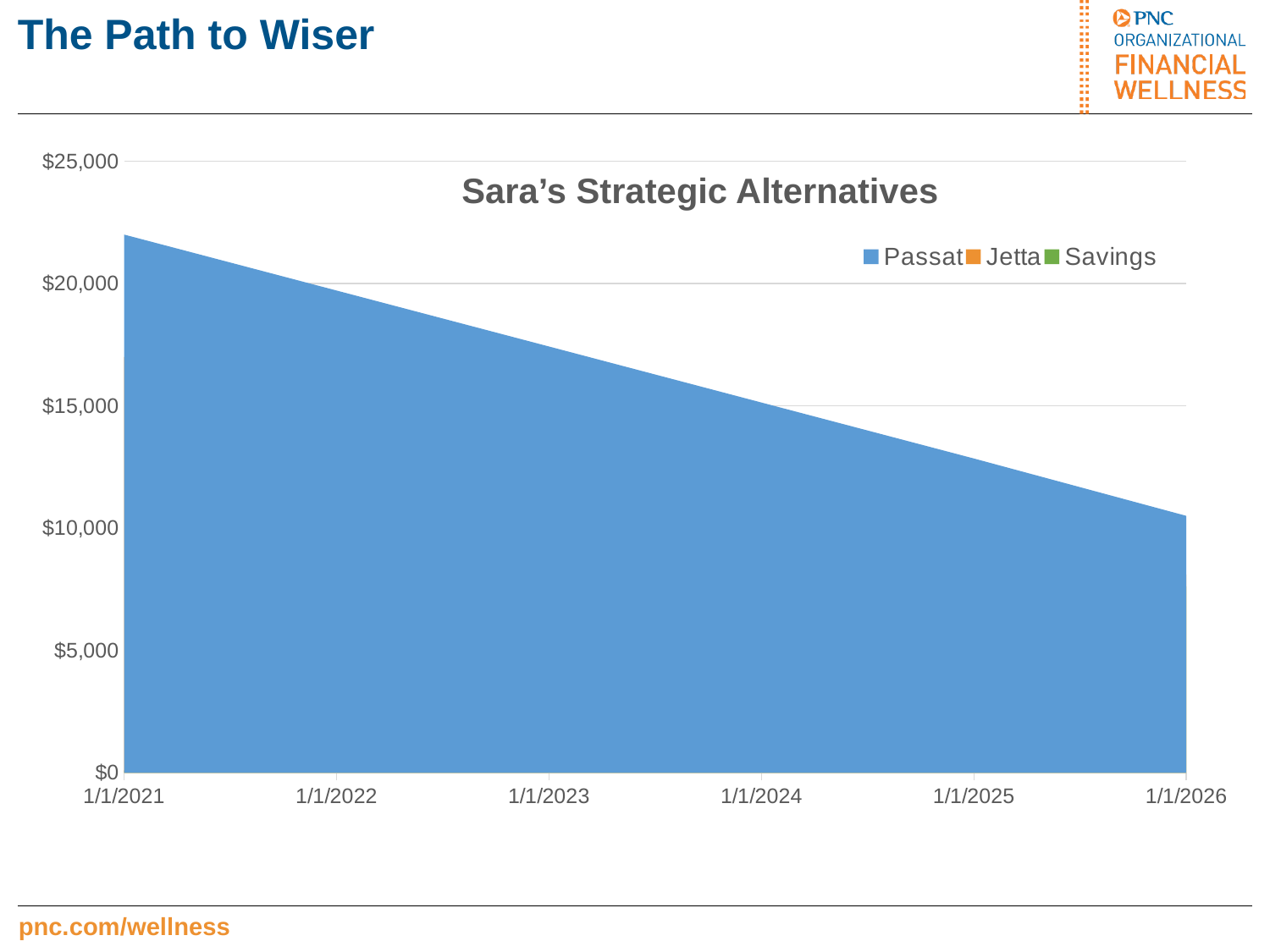
Is the Passat value at 1/1/2021 greater or less than $20,000? greater Which is larger, the Passat value at 1/1/2021 or at 1/1/2026? 1/1/2021 At which date on the x axis is the Passat value lowest? 1/1/2026 At which date on the x axis is the Passat value highest? 1/1/2021 Which series is shown in blue in the legend? Passat Does the Passat value rise or fall from 1/1/2021 to 1/1/2026? Fall How many series does the legend list? 3 What kind of chart is shown on the slide? Area chart What is the title of the chart? Sara's Strategic Alternatives Is the Passat value at 1/1/2023 greater or less than $15,000? greater Is the Passat value at 1/1/2026 greater or less than $15,000? less